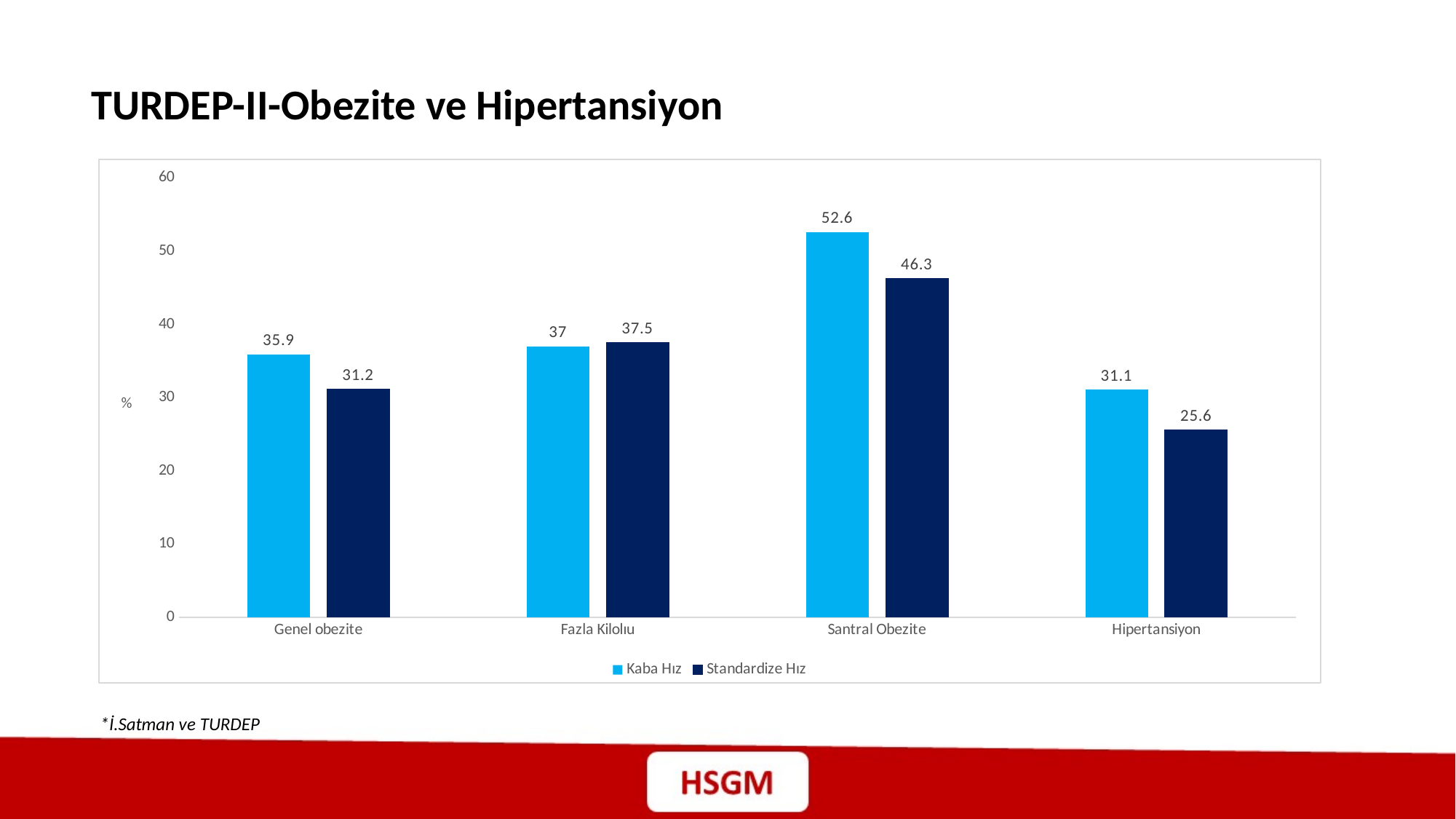
What is the Standardize Hız value for Hipertansiyon? 25.6 For Fazla Kilolu, which is larger: Kaba Hız or Standardize Hız? Standardize Hız How many series does the legend list? 2 What kind of chart is shown on the slide? bar chart Is the Kaba Hız value for Hipertansiyon greater or less than 40? less Which category has the highest Kaba Hız value? Santral Obezite Which category has the lowest Standardize Hız value? Hipertansiyon What unit label is shown on the vertical axis? % What is the difference between the Kaba Hız and Standardize Hız values for Santral Obezite? 6.3 What is the Standardize Hız value for Genel obezite? 31.2 What is the Kaba Hız value for Santral Obezite? 52.6 How many categories are shown on the x axis? 4